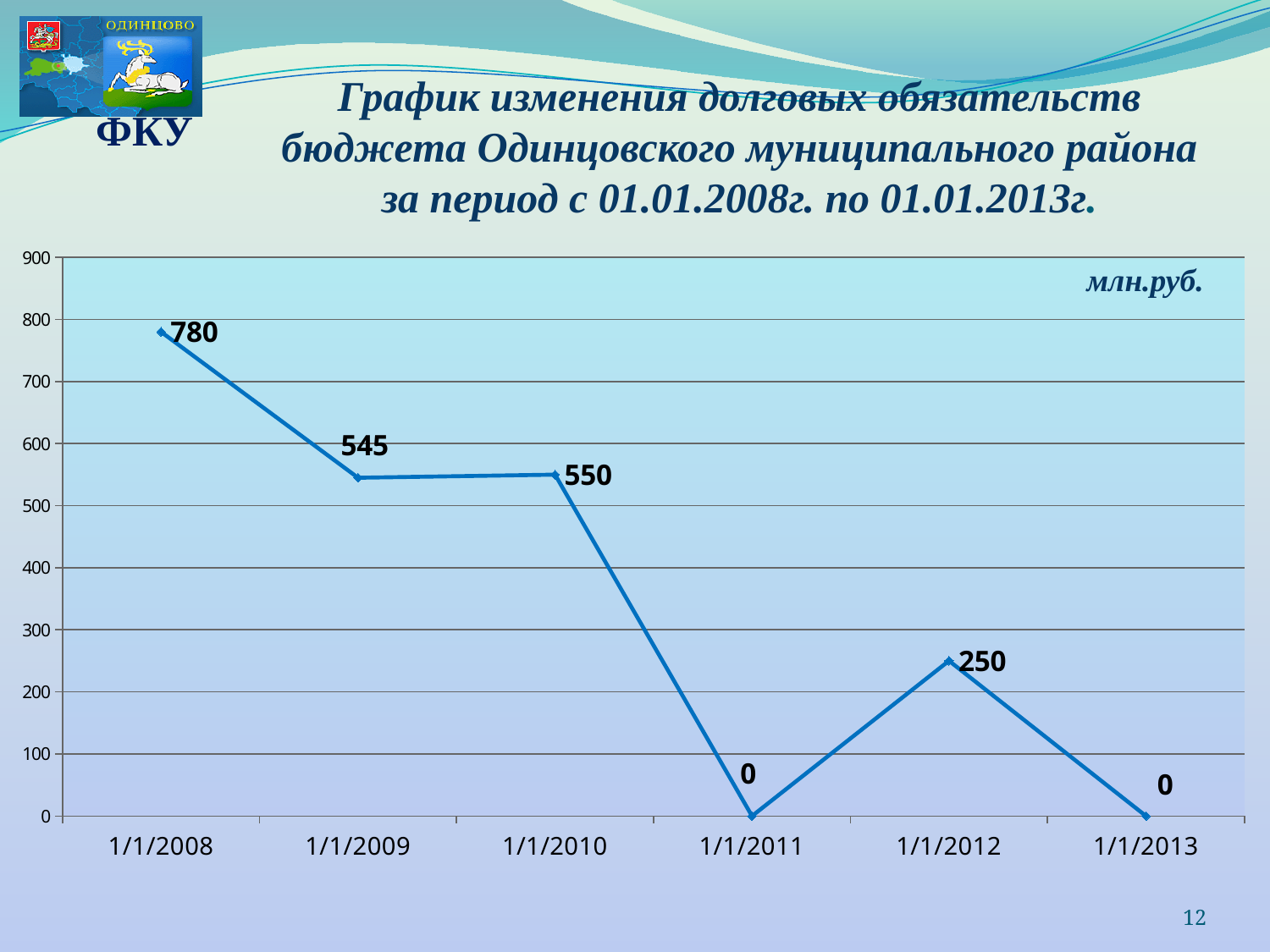
What is the value for 1/1/2009? 545 What kind of chart is shown on the slide? line chart How many data points are plotted on the chart? 6 Which date has the highest value? 1/1/2008 What is the difference between the values for 1/1/2010 and 1/1/2012? 300 Which is larger, the value for 1/1/2010 or the value for 1/1/2009? 1/1/2010 What is the difference between the values for 1/1/2008 and 1/1/2009? 235 Do the values generally rise or fall from 1/1/2008 to 1/1/2011? fall What is the value for 1/1/2012? 250 What unit is indicated in the top right corner of the chart? млн.руб. What is the value for 1/1/2011? 0 What is the value for 1/1/2008? 780